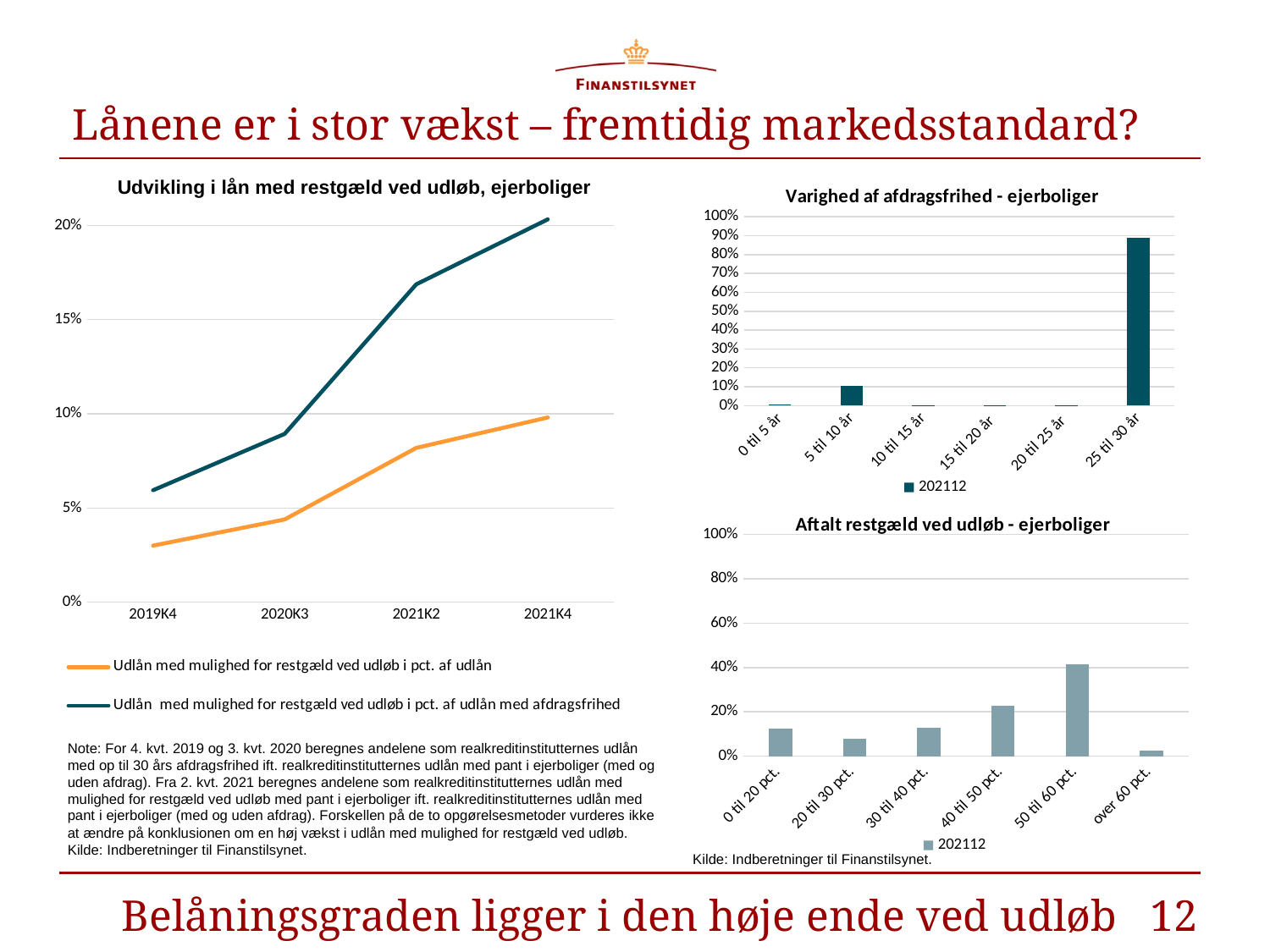
How many categories does "Varighed af afdragsfrihed - ejerboliger" show? 6 In "Udvikling i lån med restgæld ved udløb, ejerboliger", is the value for "Udlån med mulighed for restgæld ved udløb i pct. af udlån med afdragsfrihed" at 2021K4 greater or less than 20%? greater What kind of chart is "Udvikling i lån med restgæld ved udløb, ejerboliger"? line chart How many series does the legend of "Udvikling i lån med restgæld ved udløb, ejerboliger" list? 2 In "Udvikling i lån med restgæld ved udløb, ejerboliger", which series is higher at 2021K2? Udlån med mulighed for restgæld ved udløb i pct. af udlån med afdragsfrihed In "Udvikling i lån med restgæld ved udløb, ejerboliger", do the values rise or fall from 2019K4 to 2021K4? rise In "Varighed af afdragsfrihed - ejerboliger", is the value for "25 til 30 år" greater or less than 80%? greater How many points along the x axis does "Udvikling i lån med restgæld ved udløb, ejerboliger" show? 4 In "Aftalt restgæld ved udløb - ejerboliger", is the value for "40 til 50 pct." greater or less than 20%? greater In "Varighed af afdragsfrihed - ejerboliger", which category has the highest value? 25 til 30 år In "Aftalt restgæld ved udløb - ejerboliger", which category has the highest value? 50 til 60 pct.